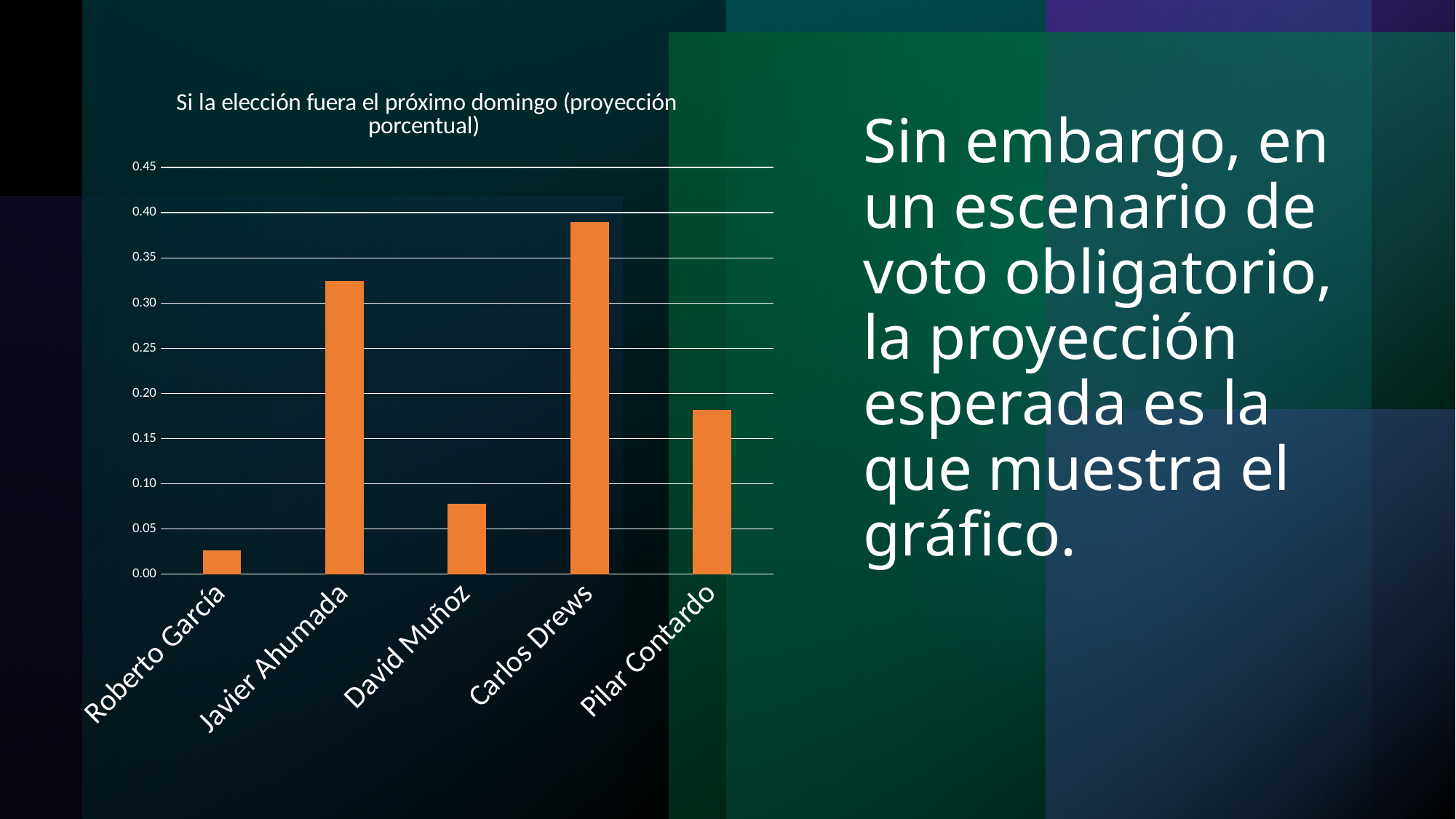
Is the value for Carlos Drews greater or less than 0.35? greater Who has the larger value, David Muñoz or Roberto García? David Muñoz How many candidates are shown on the x axis of the chart? 5 Is the value for David Muñoz greater or less than 0.10? less Is the value for Javier Ahumada greater or less than 0.30? greater What is the title of the chart? Si la elección fuera el próximo domingo (proyección porcentual) What is the highest value shown on the chart's vertical axis? 0.45 Which candidate has the lowest projected value in the chart? Roberto García Which candidate has the highest projected value in the chart? Carlos Drews What kind of chart is shown on the slide? bar chart Who has the larger value, Javier Ahumada or Pilar Contardo? Javier Ahumada